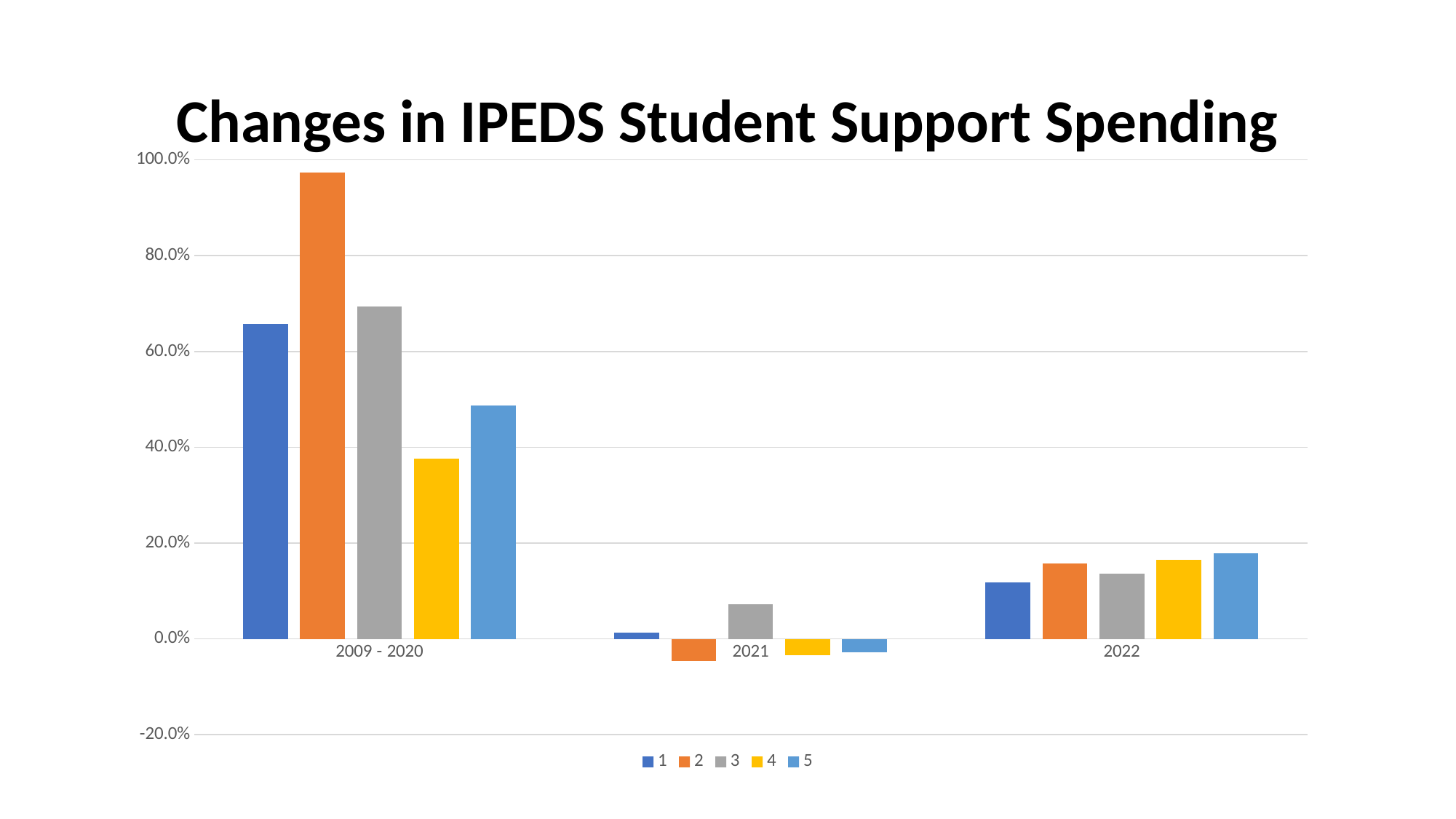
What is the title of the chart? Changes in IPEDS Student Support Spending Which series has the highest value in the 2009 - 2020 category? 2 Which series has the lowest value in the 2009 - 2020 category? 4 How many categories are shown on the x axis? 3 What kind of chart is shown on the slide? bar chart Which series has the highest value in the 2021 category? 3 Is the value for series 2 in 2009 - 2020 greater or less than 80.0%? greater Is the value for series 4 in 2009 - 2020 greater or less than 40.0%? less Is the value for series 5 in 2022 greater or less than 20.0%? less In the 2009 - 2020 category, which is larger: series 1 or series 5? series 1 How many series does the legend list? 5 What colour represents series 2 in the legend? orange